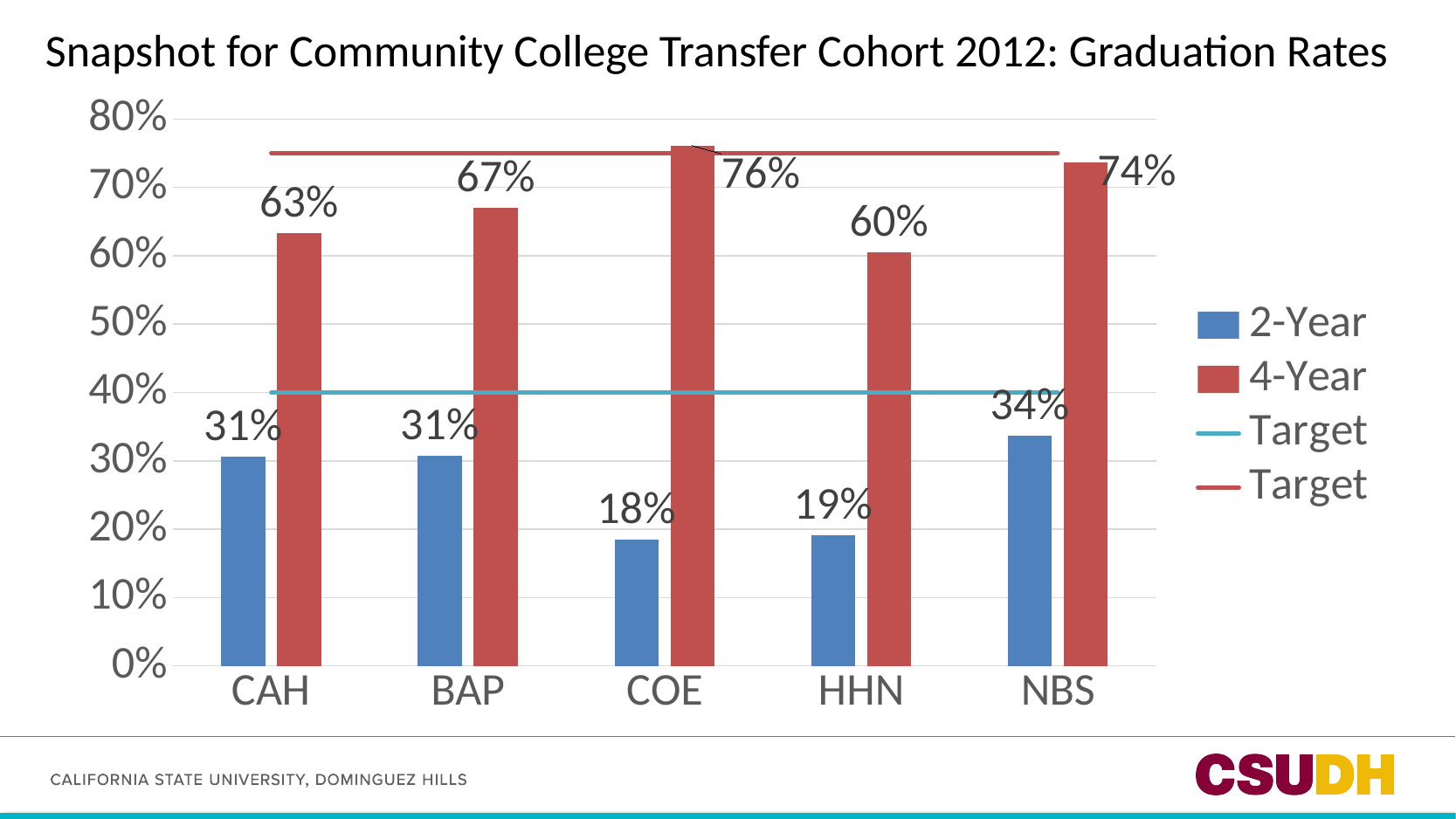
Which college has the highest 4-Year graduation rate? COE What kind of chart is shown on the slide? Combination bar and line chart What is the 2-Year graduation rate for HHN? 19% Is the 2-Year target line greater or less than 30%? greater What is the title of the chart? Snapshot for Community College Transfer Cohort 2012: Graduation Rates What is the 4-Year graduation rate for COE? 76% How many colleges are shown on the x axis? 5 Which college has the lowest 2-Year graduation rate? COE Which is larger, the 4-Year rate for HHN or the 4-Year rate for CAH? 4-Year rate for CAH How many entries does the legend list? 4 What is the 2-Year graduation rate for NBS? 34% What is the difference between the 4-Year and 2-Year graduation rates for BAP? 36%